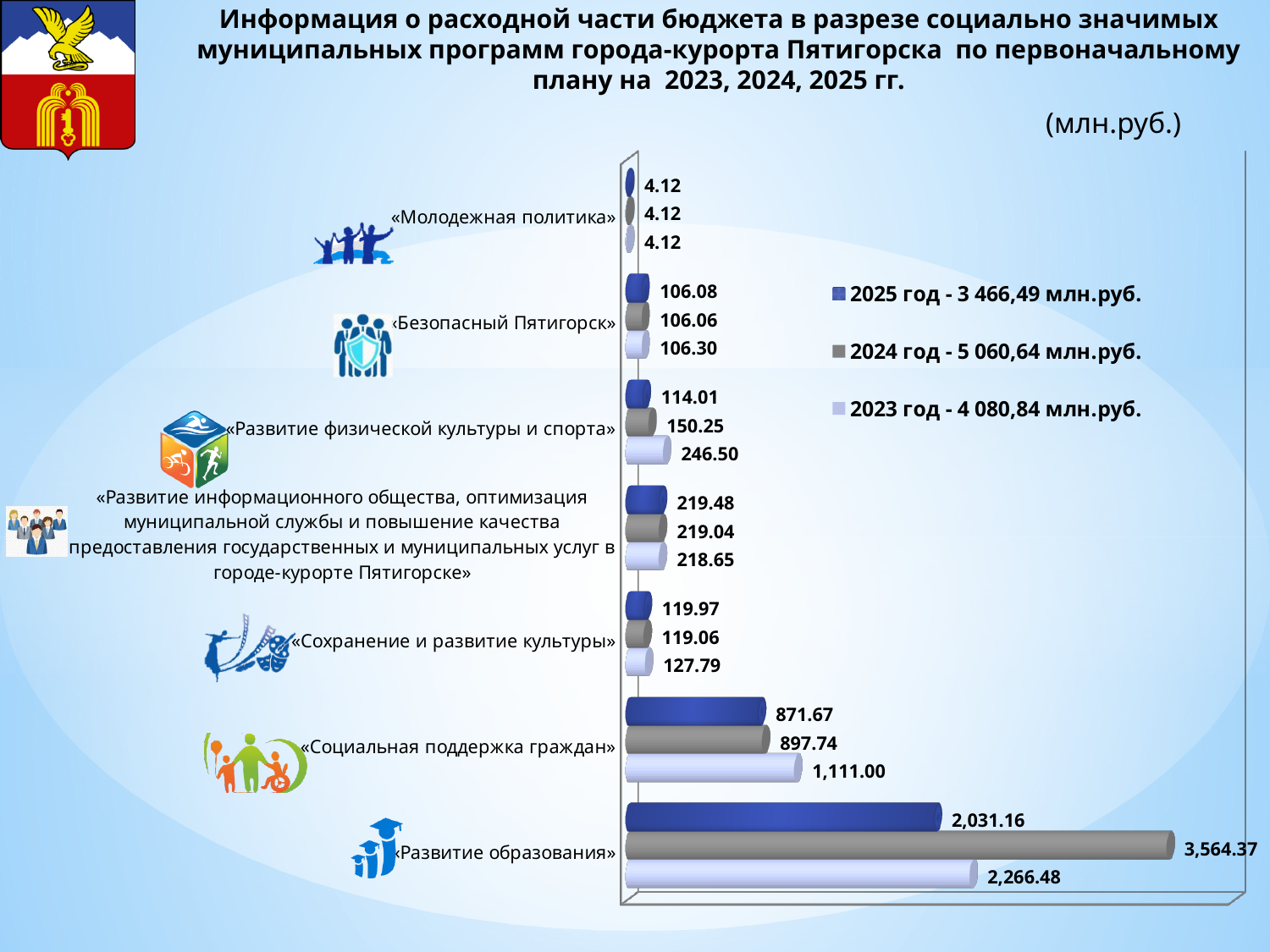
What is the 2023 value for «Социальная поддержка граждан»? 1,111.00 What kind of chart is shown on the slide? Bar chart Which program has the highest 2025 value? «Развитие образования» What is the difference between the 2023 and 2024 values for «Социальная поддержка граждан»? 213.26 What is the 2024 value for «Развитие образования»? 3,564.37 According to the legend, what is the total for 2024 год? 5 060,64 млн.руб. For «Развитие физической культуры и спорта», which year has the larger value, 2023 or 2025? 2023 How many series does the legend list? 3 How many programs (categories) are shown in the chart? 7 Which program has the lowest 2023 value? «Молодежная политика» What is the difference between the 2024 and 2025 values for «Развитие образования»? 1,533.21 What is the 2025 value for «Сохранение и развитие культуры»? 119.97